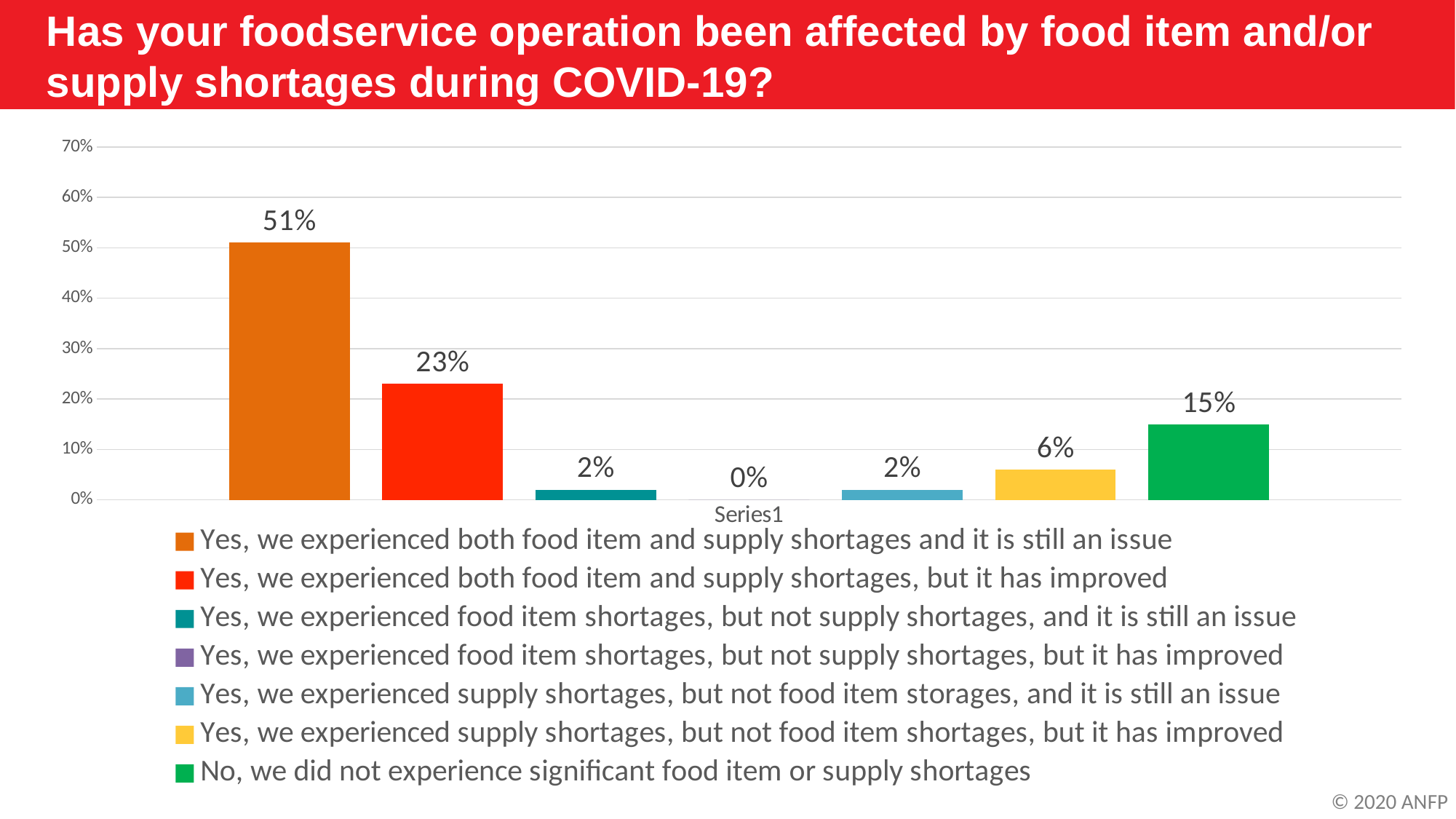
How many response options are listed in the legend? 7 What percentage of respondents said they did not experience significant food item or supply shortages? 15% What percentage of respondents said they experienced both food item and supply shortages, but it has improved? 23% Which is larger: the percentage for 'No, we did not experience significant food item or supply shortages' or the percentage for 'supply shortages, but not food item shortages, but it has improved'? No, we did not experience significant food item or supply shortages Which response option has the highest percentage? Yes, we experienced both food item and supply shortages and it is still an issue What percentage of respondents said they experienced both food item and supply shortages and it is still an issue? 51% Which response option has the lowest percentage? Yes, we experienced food item shortages, but not supply shortages, but it has improved What percentage of respondents said they experienced food item shortages, but not supply shortages, but it has improved? 0% What percentage of respondents said they experienced supply shortages, but not food item shortages, but it has improved? 6% What colour is the bar for 'No, we did not experience significant food item or supply shortages'? Green What type of chart is shown on the slide? Bar chart What is the difference in percentage points between the 'both shortages, still an issue' response and the 'both shortages, but it has improved' response? 28